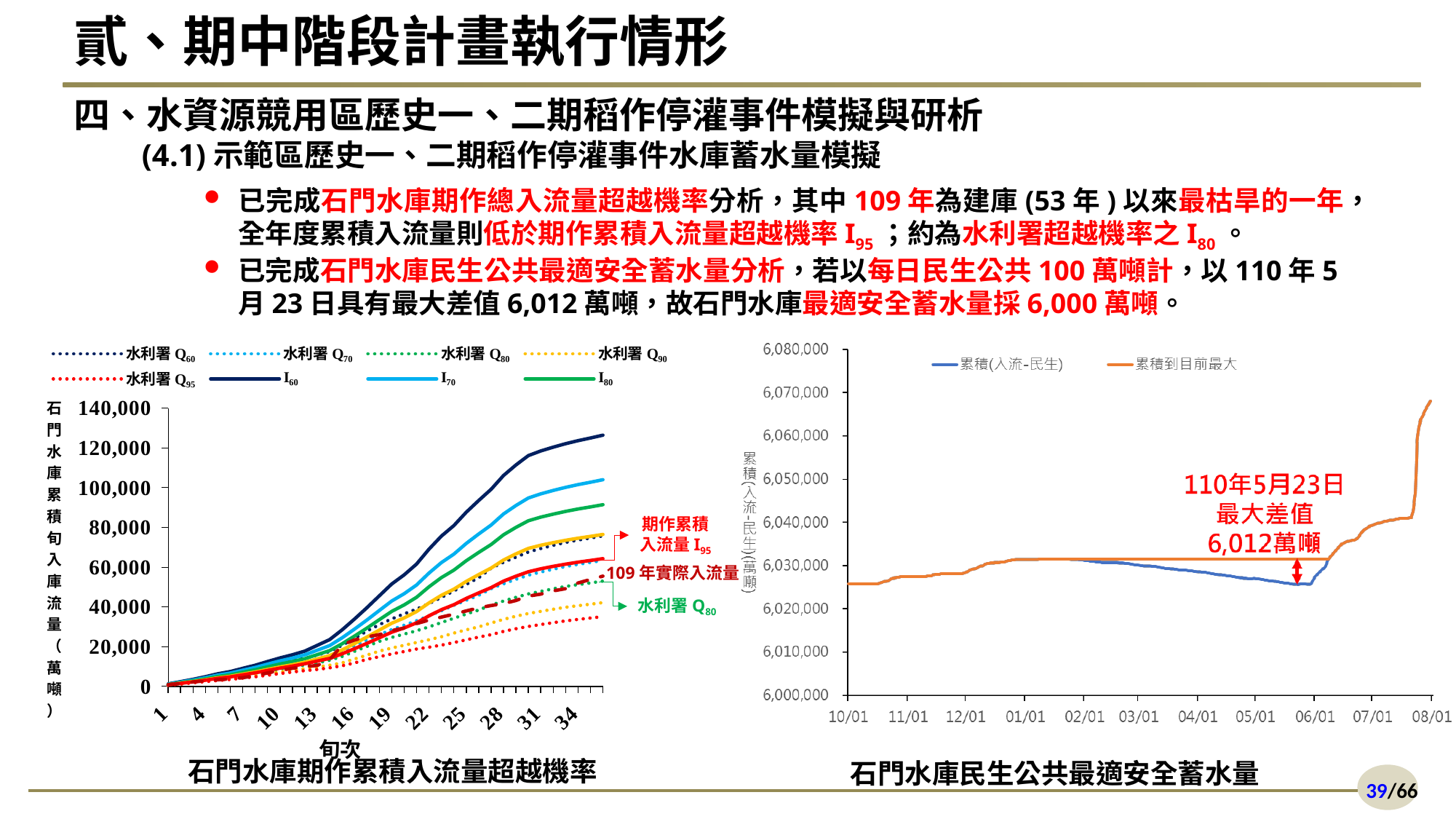
In the left chart 石門水庫期作累積入流量超越機率, how many series does the legend list? 8 In the right chart 石門水庫民生公共最適安全蓄水量, what is the 最大差值 annotated on 110年5月23日? 6,012萬噸 In the left chart 石門水庫期作累積入流量超越機率, which series ends higher, I60 or I70? I60 In the left chart 石門水庫期作累積入流量超越機率, which series is lowest at the last 旬次? 水利署 Q95 What kind of chart is the right chart titled 石門水庫民生公共最適安全蓄水量? line chart In the left chart 石門水庫期作累積入流量超越機率, is the final value of I60 greater or less than 120,000? greater In the left chart 石門水庫期作累積入流量超越機率, is the final value of I80 greater or less than 100,000? less In the right chart 石門水庫民生公共最適安全蓄水量, how many series does the legend list? 2 In the right chart 石門水庫民生公共最適安全蓄水量, does the 累積到目前最大 series rise or fall from 10/01 to 08/01? rise In the left chart 石門水庫期作累積入流量超越機率, which series is highest at the last 旬次? I60 What kind of chart is the left chart titled 石門水庫期作累積入流量超越機率? line chart In the right chart 石門水庫民生公共最適安全蓄水量, what is the first date label on the x axis? 10/01